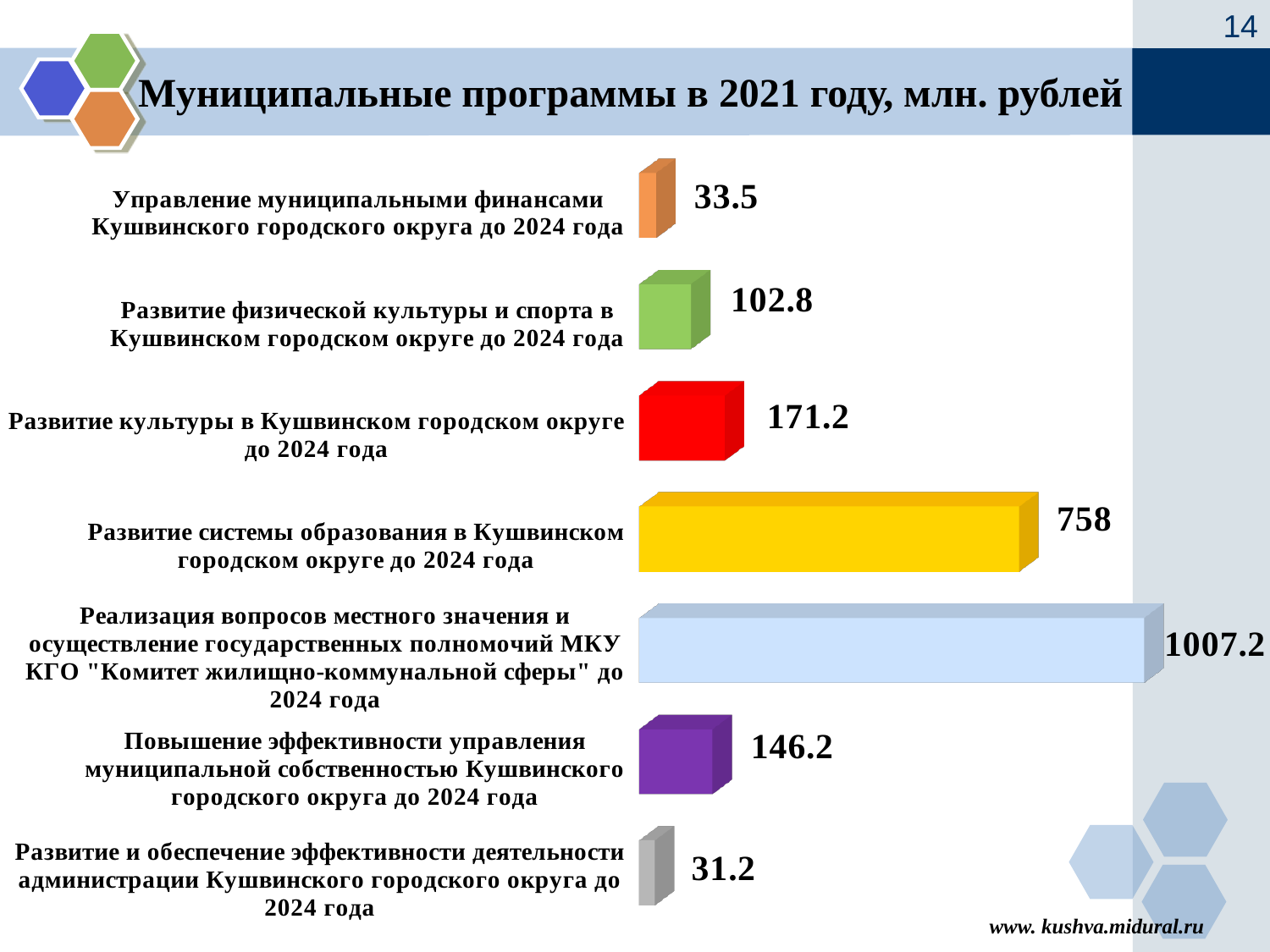
What is the difference between the values for «Развитие системы образования» and «Развитие культуры»? 586.8 What kind of chart is shown on the slide? Bar chart What is the title of the chart? Муниципальные программы в 2021 году, млн. рублей What is the value for «Развитие системы образования в Кушвинском городском округе до 2024 года»? 758 Which municipal program has the lowest value? Развитие и обеспечение эффективности деятельности администрации Кушвинского городского округа до 2024 года What is the value for «Развитие культуры в Кушвинском городском округе до 2024 года»? 171.2 Which is larger: the value for «Развитие физической культуры и спорта» or for «Повышение эффективности управления муниципальной собственностью»? Повышение эффективности управления муниципальной собственностью Which municipal program has the highest value? Реализация вопросов местного значения и осуществление государственных полномочий МКУ КГО "Комитет жилищно-коммунальной сферы" до 2024 года What is the value for «Повышение эффективности управления муниципальной собственностью Кушвинского городского округа до 2024 года»? 146.2 What is the difference between the values for «Реализация вопросов местного значения...» and «Развитие системы образования»? 249.2 How many municipal programs are shown in the chart? 7 What is the value for «Управление муниципальными финансами Кушвинского городского округа до 2024 года»? 33.5